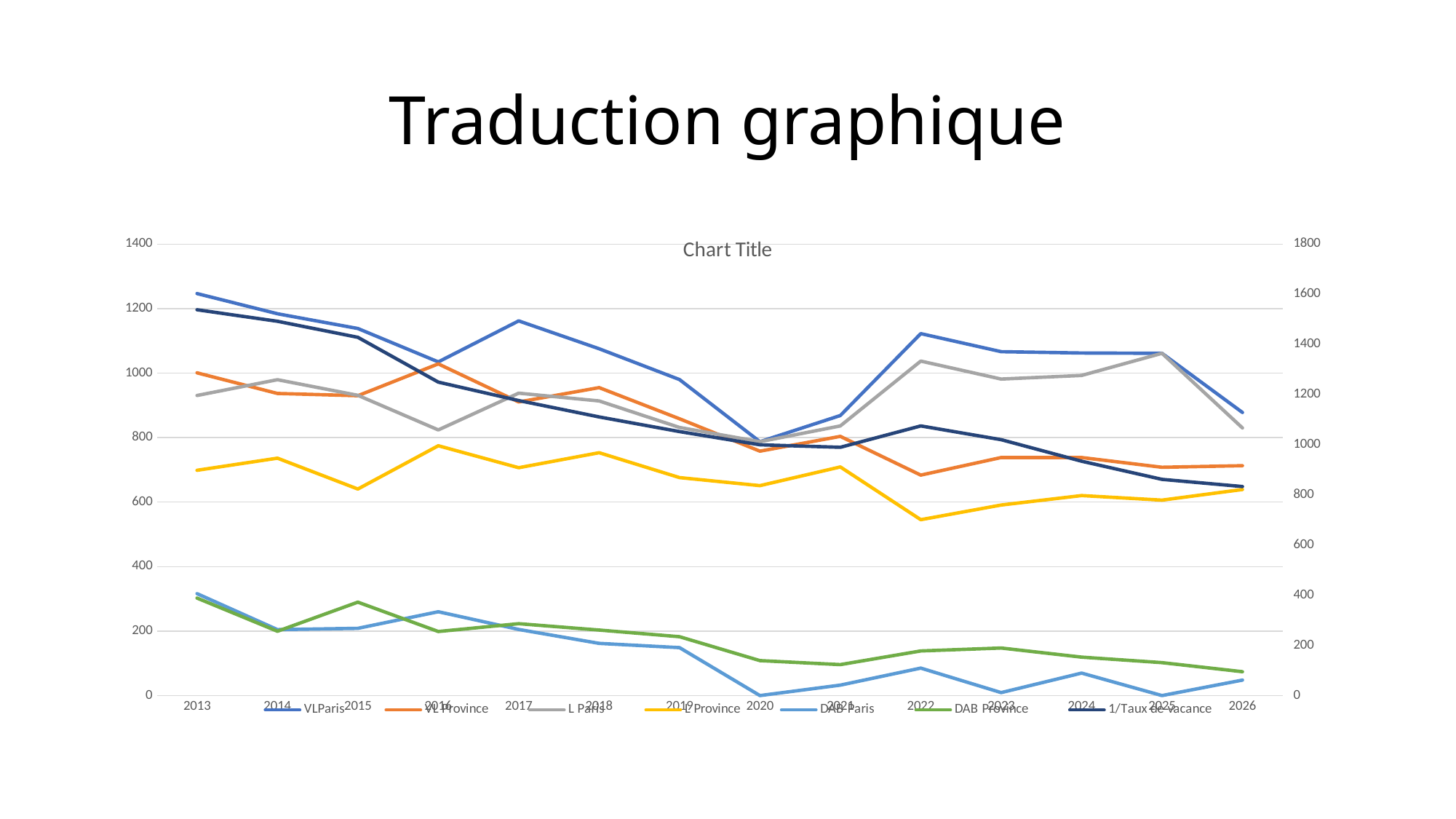
In which year is the VLParis line at its highest? 2013 Is the VLParis value for 2013 larger or smaller than its value for 2026? larger Which series is drawn with the yellow line? L Province How many years are plotted along the x axis? 14 How many series does the chart legend list? 7 In which year is the VLParis line at its lowest? 2020 Is the value for DAB Paris in 2020 greater or less than 200? less Does the 1/Taux de vacance line generally rise or fall from 2013 to 2026? fall What is the title shown on the chart? Chart Title What kind of chart is shown on the slide? line chart In which year is the L Province line at its lowest? 2022 In which year is the 1/Taux de vacance line at its lowest? 2026